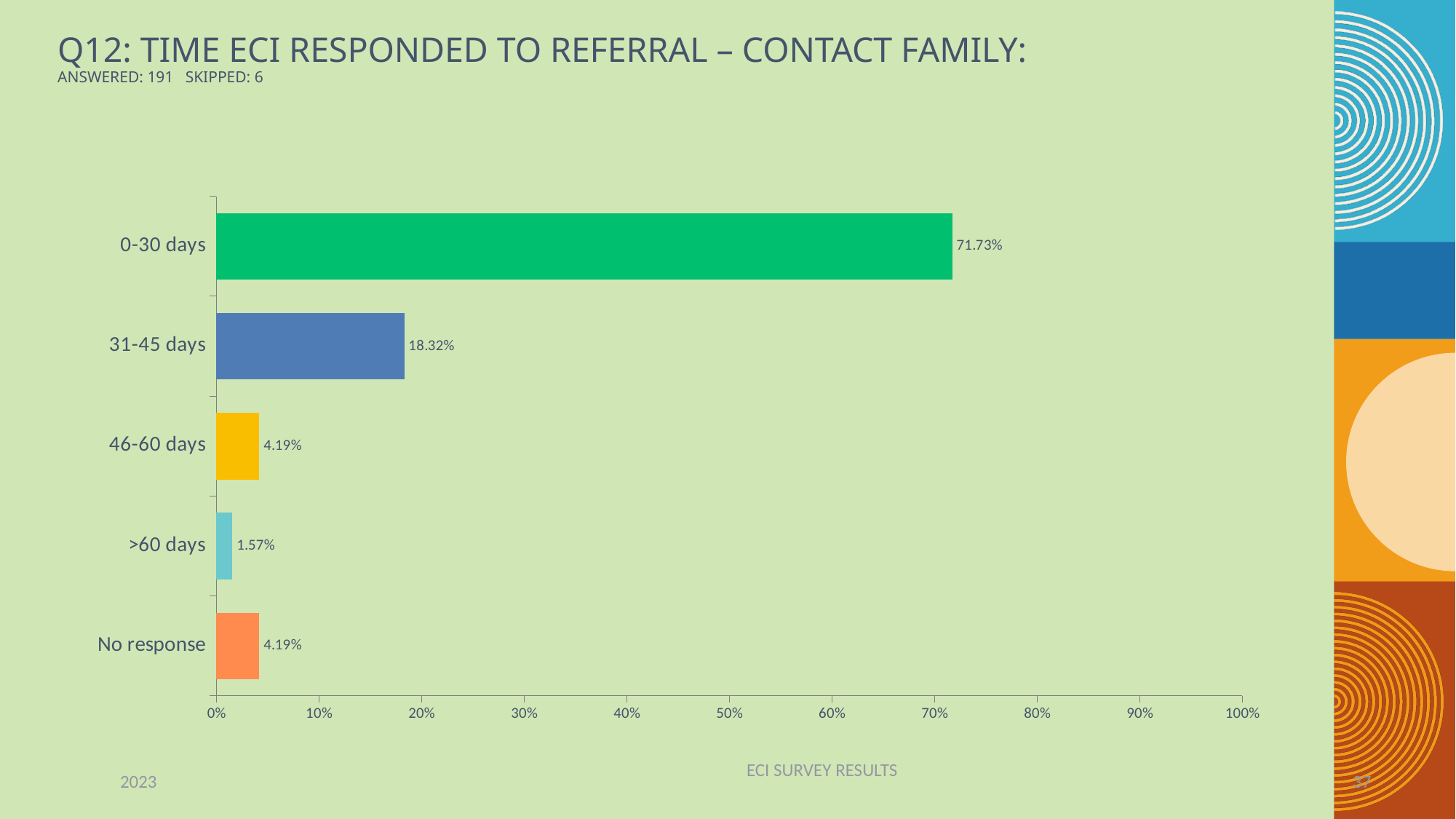
What percentage is shown for >60 days? 1.57% What percentage is shown for No response? 4.19% Is the value for 0-30 days greater or less than 70%? greater Which category has the highest percentage? 0-30 days What percentage is shown for 31-45 days? 18.32% How many respondents answered this question according to the slide? 191 Which is larger, the value for 31-45 days or the value for 46-60 days? 31-45 days What kind of chart is shown on the slide? Bar chart What percentage is shown for 0-30 days? 71.73% Which category has the lowest percentage? >60 days What is the difference between the percentages for 0-30 days and 31-45 days? 53.41% How many categories are shown on the chart? 5